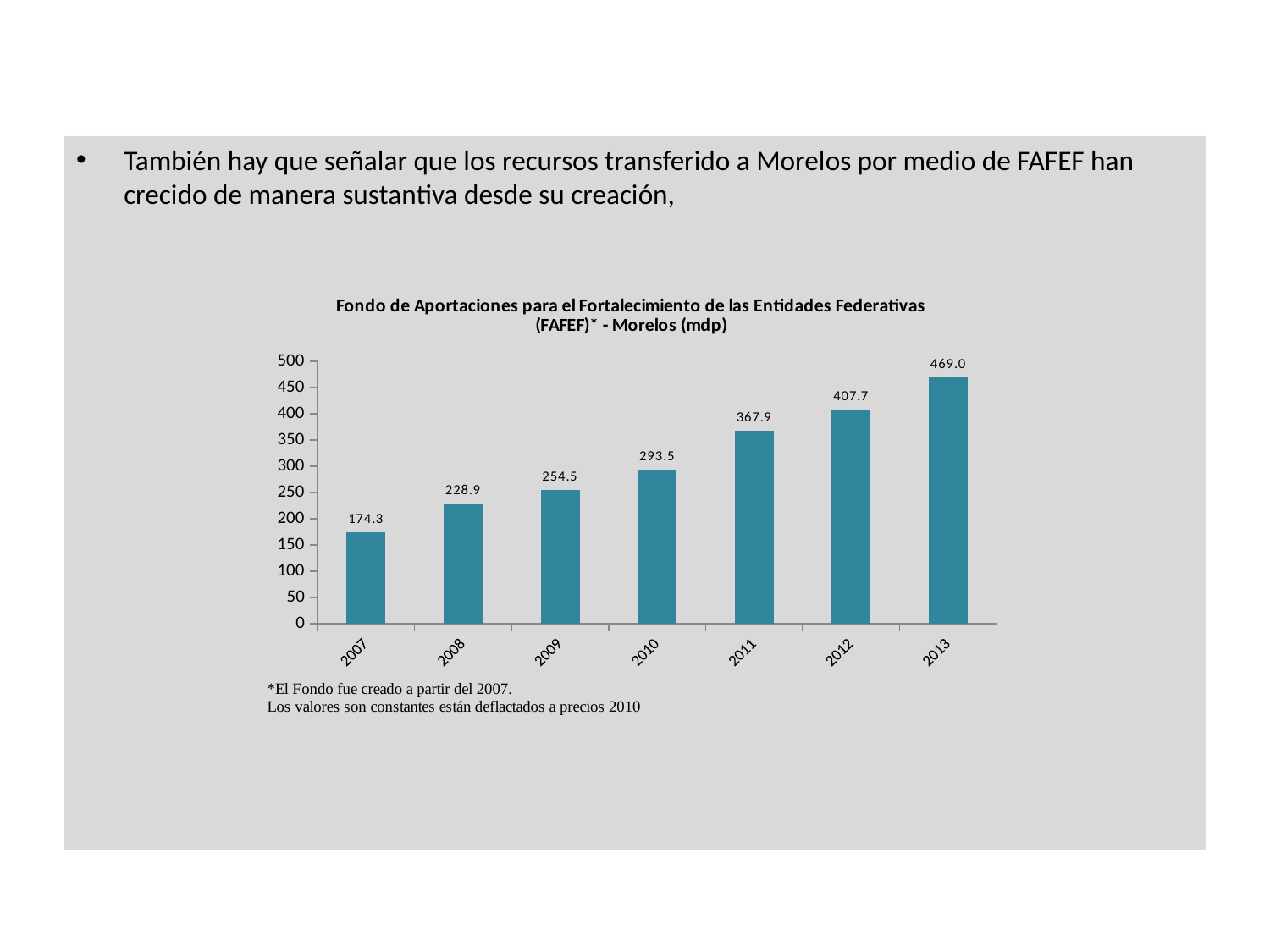
How many years are shown on the x axis? 7 What is the value for 2013? 469.0 What is the value for 2007? 174.3 Which year has the lowest value? 2007 What is the value for 2010? 293.5 Do the values rise or fall from 2007 to 2013? Rise What kind of chart is shown? Bar chart Is the value for 2012 greater or less than 400? greater What is the difference between the values for 2013 and 2007? 294.7 Which year has the highest value? 2013 Which is larger, the value for 2009 or the value for 2011? 2011 What is the difference between the values for 2012 and 2011? 39.8